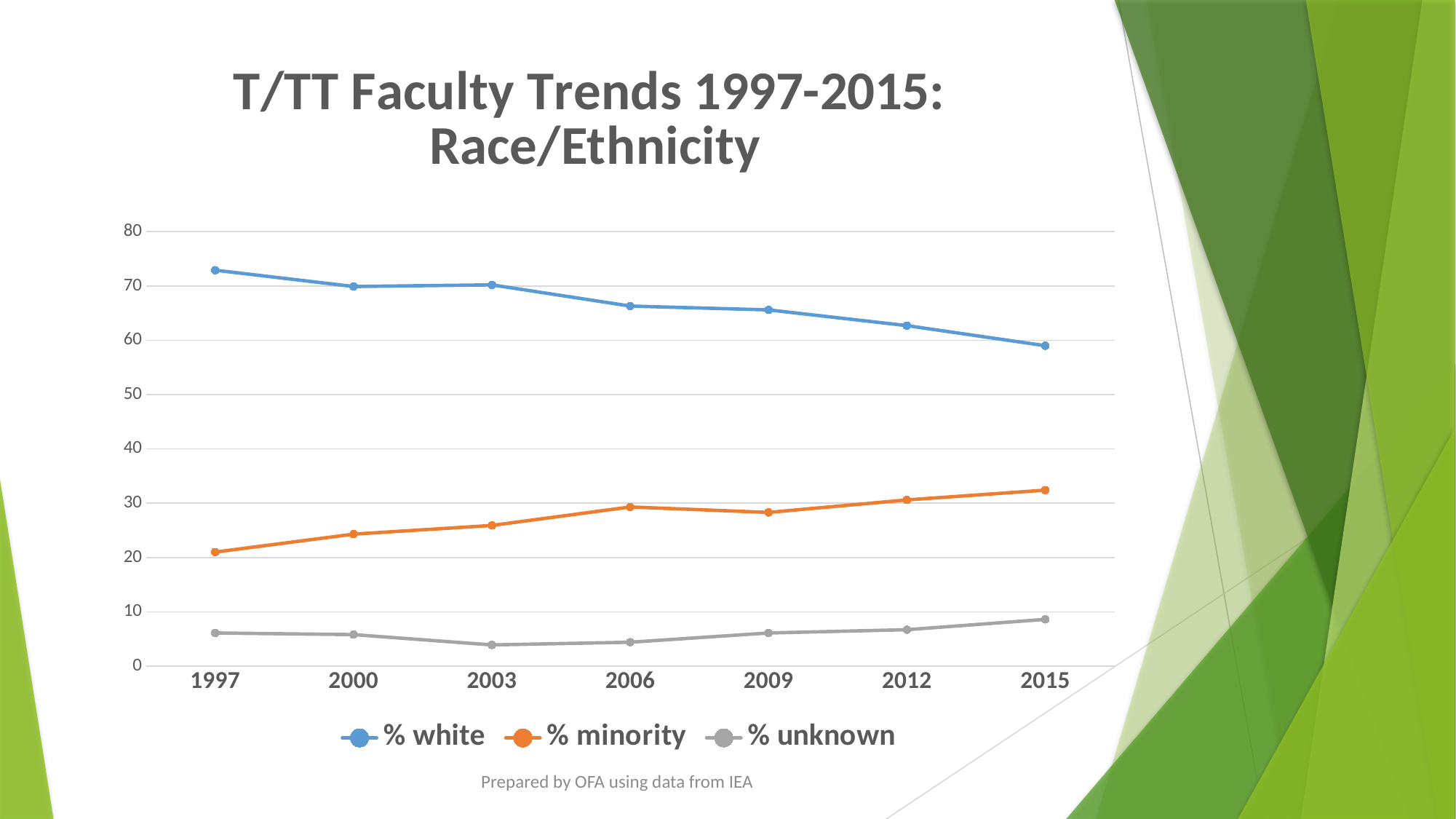
Is the % white value for 1997 greater or less than 70? greater Does the % minority series rise or fall from 1997 to 2015? rise How many series does the legend list? 3 Is the % minority value for 2015 greater or less than 30? greater What kind of chart is shown on the slide? line chart How many years are plotted along the x axis? 7 In which year is the % minority value highest? 2015 Which series is shown in orange in the legend? % minority Does the % white series rise or fall from 1997 to 2015? fall In which year is the % unknown value highest? 2015 In which year is the % white value lowest? 2015 In which year is the % white value highest? 1997